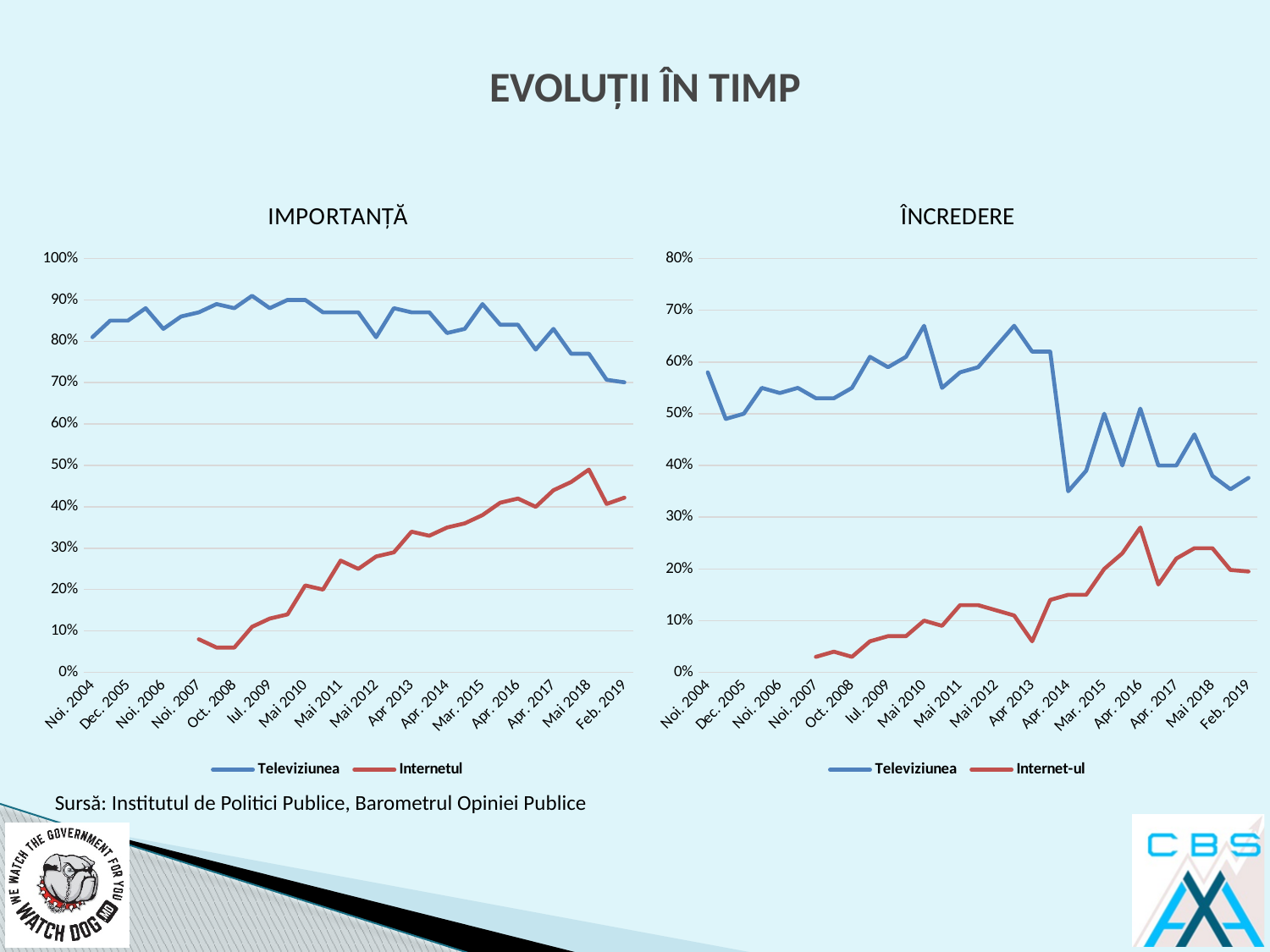
What kind of chart is the IMPORTANȚĂ chart on the left? line chart In the IMPORTANȚĂ chart, does the Internetul series rise or fall overall from Noi. 2007 to Feb. 2019? rise In the IMPORTANȚĂ chart, at which date does the Internetul series reach its highest value? Mai 2018 In the ÎNCREDERE chart, does the Televiziunea series rise or fall overall from Noi. 2004 to Feb. 2019? fall In the ÎNCREDERE chart, is the value for Internet-ul at Apr. 2016 greater or less than 20%? greater In the IMPORTANȚĂ chart, which series has the larger value at Feb. 2019, Televiziunea or Internetul? Televiziunea In the IMPORTANȚĂ chart, is the value for Internetul at Noi. 2007 greater or less than 10%? less In the ÎNCREDERE chart, is the value for Televiziunea at Noi. 2004 greater or less than 50%? greater How many series does the legend of the ÎNCREDERE chart list? 2 In the ÎNCREDERE chart, at which date does the Internet-ul series reach its highest value? Apr. 2016